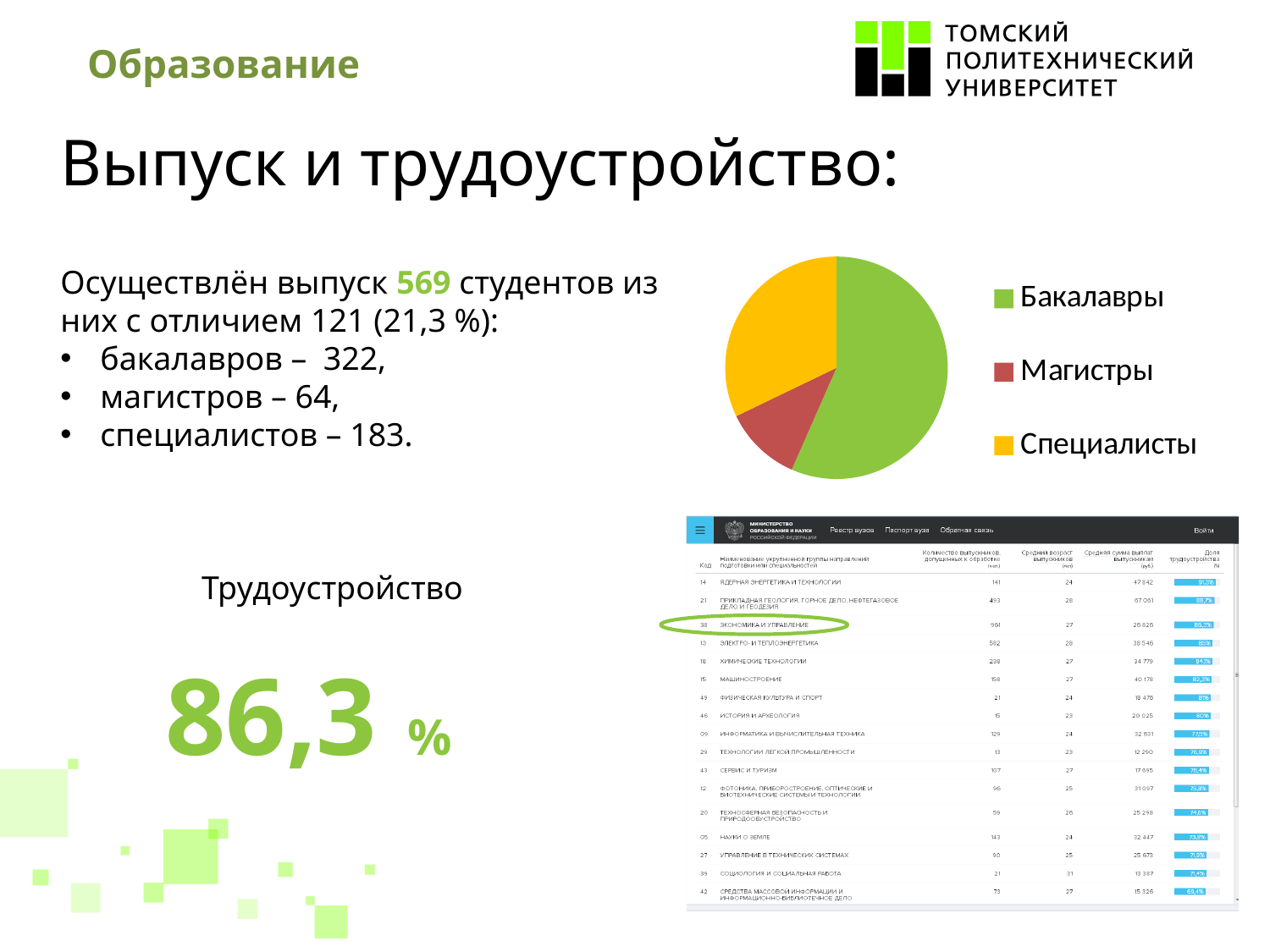
In the pie chart, which slice is larger: Специалисты or Магистры? Специалисты How many entries does the legend of the pie chart list? 3 How many slices does the pie chart have? 3 What kind of chart is shown on the slide? pie chart Which category has the smallest slice in the pie chart? Магистры In the pie chart, which slice is larger: Бакалавры or Специалисты? Бакалавры What colour is the Бакалавры slice in the pie chart? green Which category has the largest slice in the pie chart? Бакалавры Which category is shown in yellow in the pie chart? Специалисты